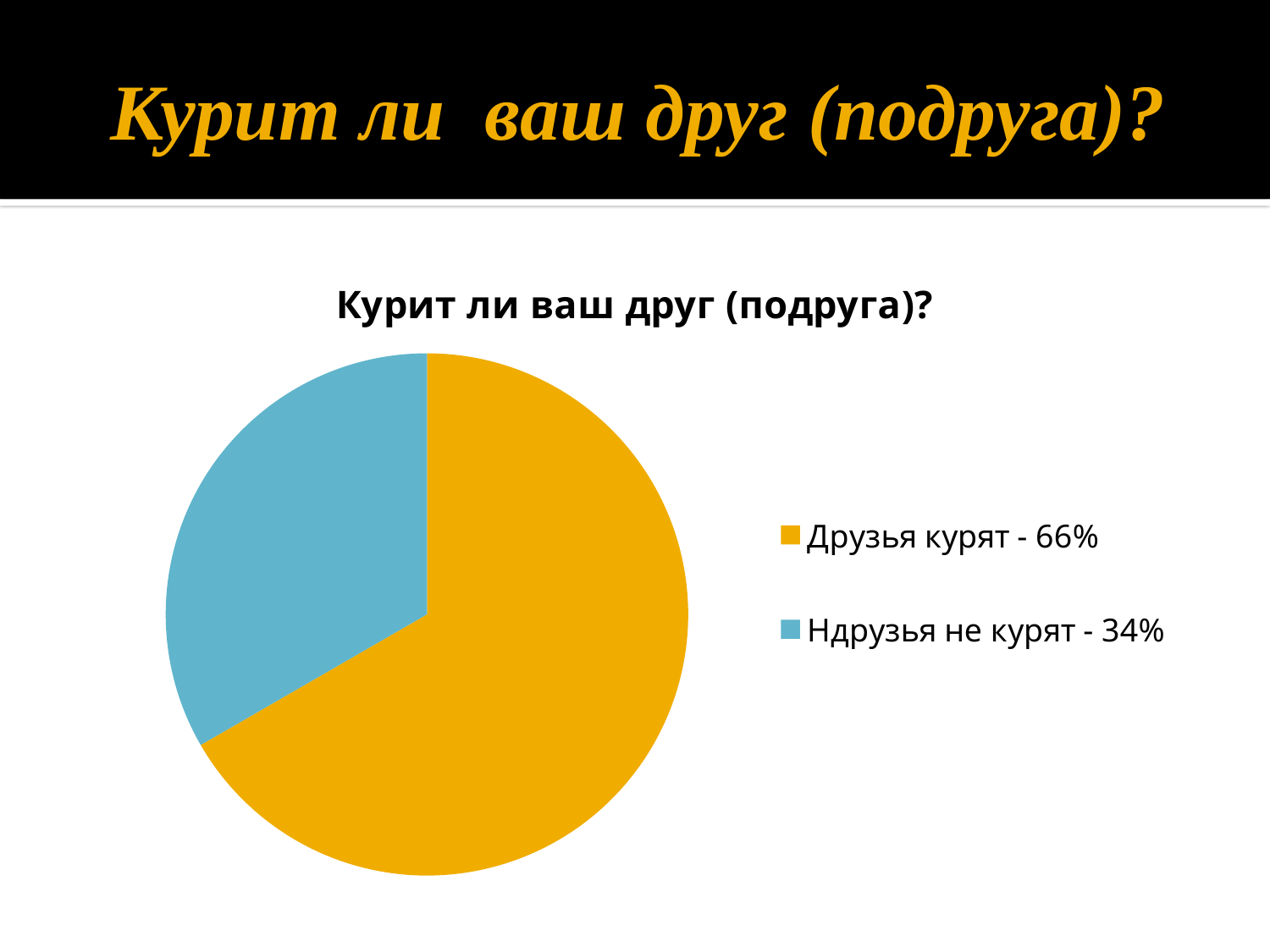
Which slice is the largest? Друзья курят - 66% What share of the pie is labelled "Ндрузья не курят"? 34% What colour is the "Друзья курят" slice? yellow What is the title of the chart? Курит ли ваш друг (подруга)? How many entries does the legend list? 2 How many slices does the pie chart have? 2 Is the share for "Друзья курят" greater or less than 50%? greater What share of the pie is labelled "Друзья курят"? 66% What is the difference in percentage points between the "Друзья курят" slice and the "Ндрузья не курят" slice? 32 Which is larger: the "Друзья курят" slice or the "Ндрузья не курят" slice? Друзья курят What kind of chart is shown on the slide? pie chart Which slice is the smallest? Ндрузья не курят - 34%